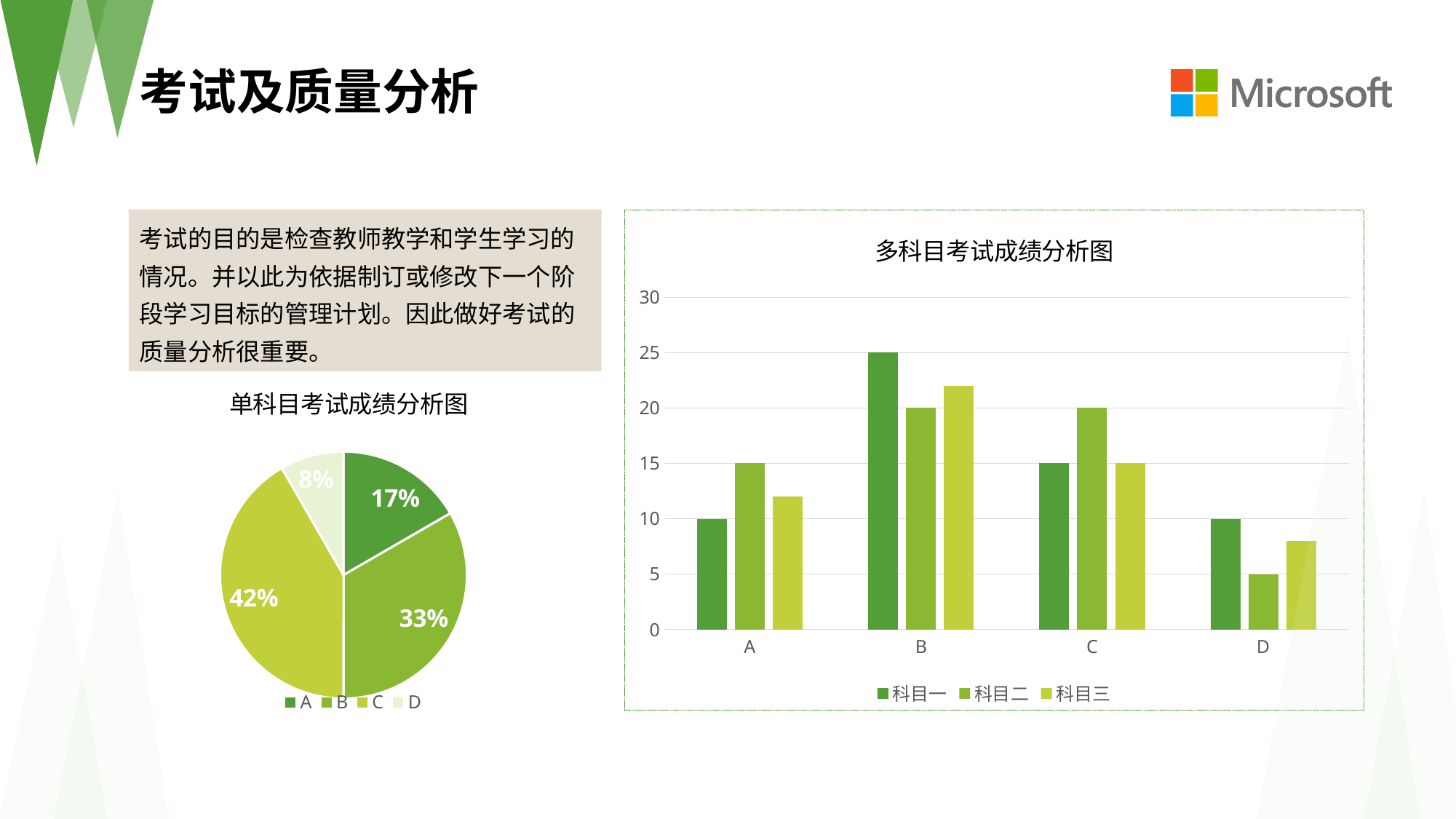
How many series does the legend of the bar chart 多科目考试成绩分析图 list? 3 In the pie chart 单科目考试成绩分析图, how many slices are there? 4 What kind of chart is 多科目考试成绩分析图? Bar chart In the bar chart 多科目考试成绩分析图, what is the value of 科目一 for category B? 25 In the pie chart 单科目考试成绩分析图, what is the difference between the shares of B and A? 16% In the bar chart 多科目考试成绩分析图, which is larger for category C: 科目一 or 科目二? 科目二 In the bar chart 多科目考试成绩分析图, which category has the highest 科目一 value? B In the pie chart 单科目考试成绩分析图, which slice is the smallest? D In the bar chart 多科目考试成绩分析图, is the value of 科目三 for category B greater or less than 20? greater In the bar chart 多科目考试成绩分析图, what is the value of 科目二 for category D? 5 In the pie chart 单科目考试成绩分析图, what share does slice C have? 42% In the bar chart 多科目考试成绩分析图, is the value of 科目三 for category D greater or less than 10? less